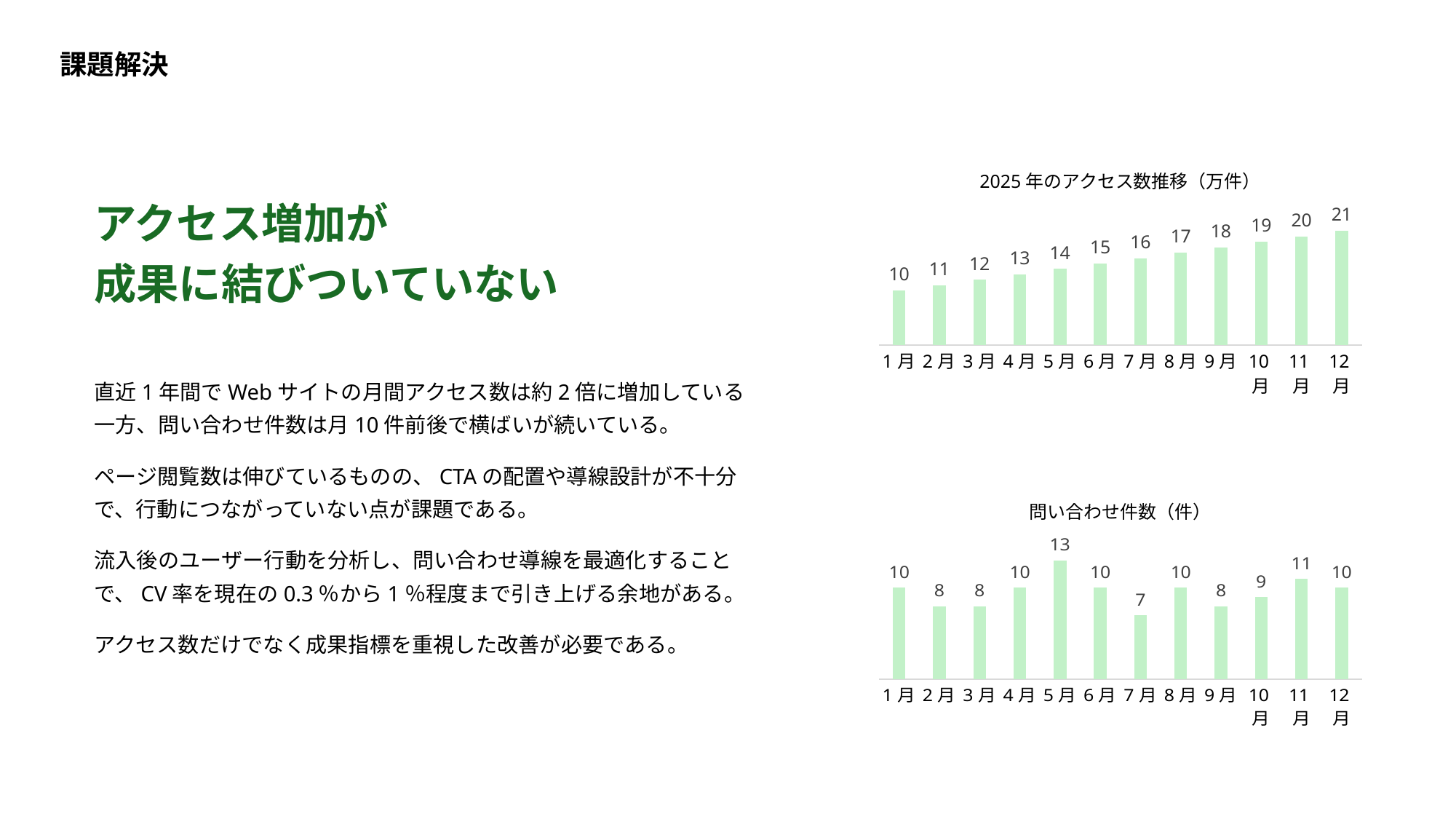
What kind of chart is the chart titled 問い合わせ件数（件）? bar chart In the chart titled 問い合わせ件数（件）, which month has the highest value? 5 月 In the chart titled 問い合わせ件数（件）, what is the difference between the values for 5 月 and 7 月? 6 In the chart titled 2025 年のアクセス数推移（万件）, what is the value for 6 月? 15 In the chart titled 問い合わせ件数（件）, which month has the lowest value? 7 月 What is the title of the upper chart on the slide? 2025 年のアクセス数推移（万件） In the chart titled 2025 年のアクセス数推移（万件）, how many months are plotted? 12 In the chart titled 2025 年のアクセス数推移（万件）, which month has the highest value? 12 月 In the chart titled 問い合わせ件数（件）, which is larger, the value for 11 月 or the value for 9 月? 11 月 In the chart titled 2025 年のアクセス数推移（万件）, what is the difference between the values for 12 月 and 1 月? 11 In the chart titled 問い合わせ件数（件）, what is the value for 5 月? 13 In the chart titled 2025 年のアクセス数推移（万件）, do the values rise or fall from 1 月 to 12 月? rise